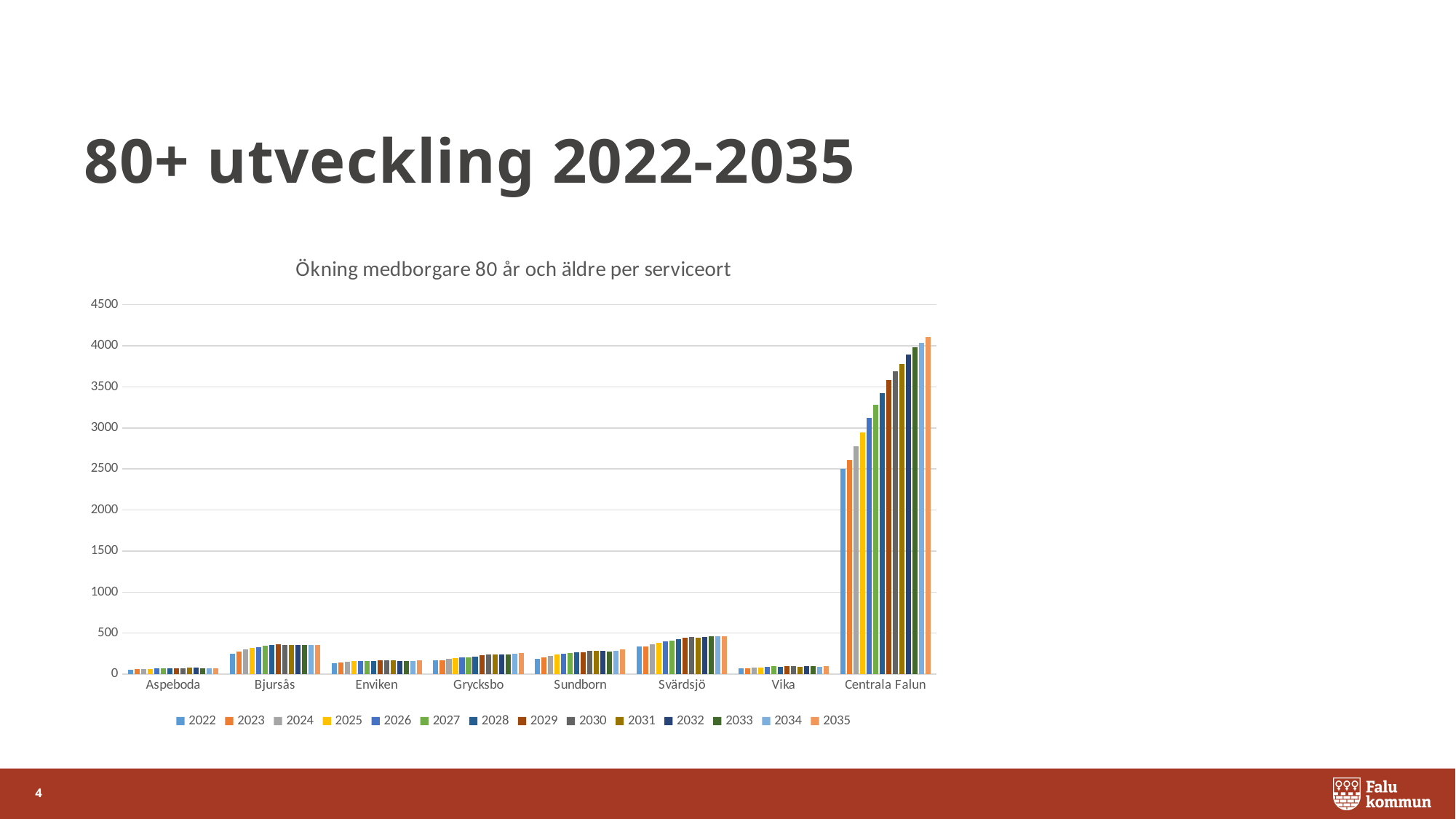
Which has the larger value in 2035, Svärdsjö or Enviken? Svärdsjö Which service location has the highest values in the chart? Centrala Falun Is the value for Centrala Falun in 2035 greater or less than 3500? greater How many service locations (categories) are shown on the x axis of the chart? 8 Do the values for Centrala Falun rise or fall from 2022 to 2035? rise What kind of chart is shown on the slide? Bar chart What is the first year listed in the chart legend? 2022 Is the value for Bjursås in 2022 greater or less than 500? less How many series (years) does the chart legend list? 14 What is the title of the chart? Ökning medborgare 80 år och äldre per serviceort Is the value for Centrala Falun in 2028 greater or less than 2500? greater